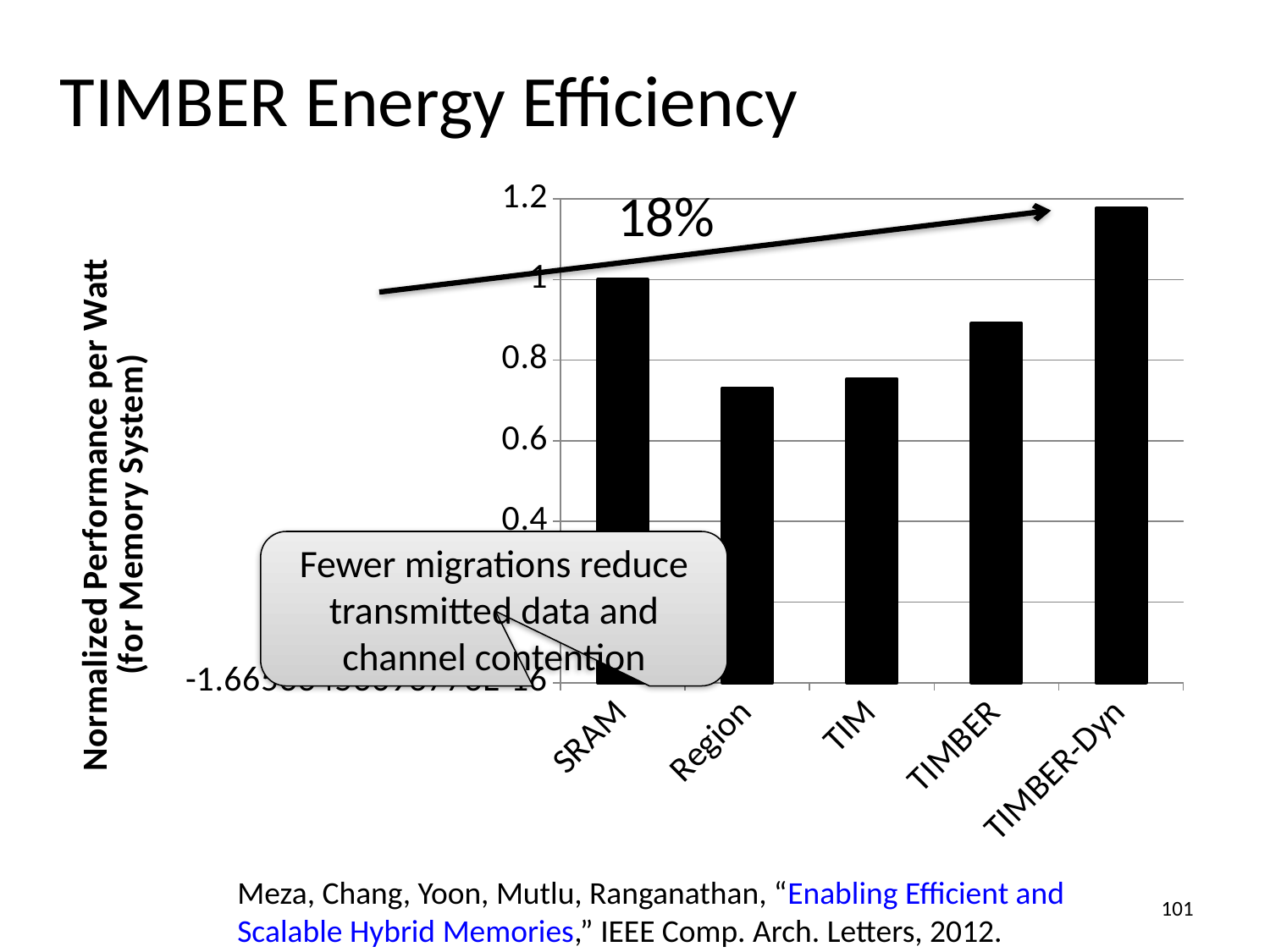
Which has a higher value, SRAM or TIM? SRAM Is the value for TIMBER-Dyn greater or less than 1? greater What is the normalized performance per watt for SRAM? 1 What is the label of the y axis? Normalized Performance per Watt (for Memory System) Which category has the highest normalized performance per watt? TIMBER-Dyn Is the value for Region greater or less than 0.8? less How many categories are plotted on the x axis? 5 What kind of chart is shown on the slide? bar chart Is the value for TIMBER greater or less than 0.8? greater Which has a higher value, TIMBER or Region? TIMBER What percentage is written next to the arrow annotation on the chart? 18%